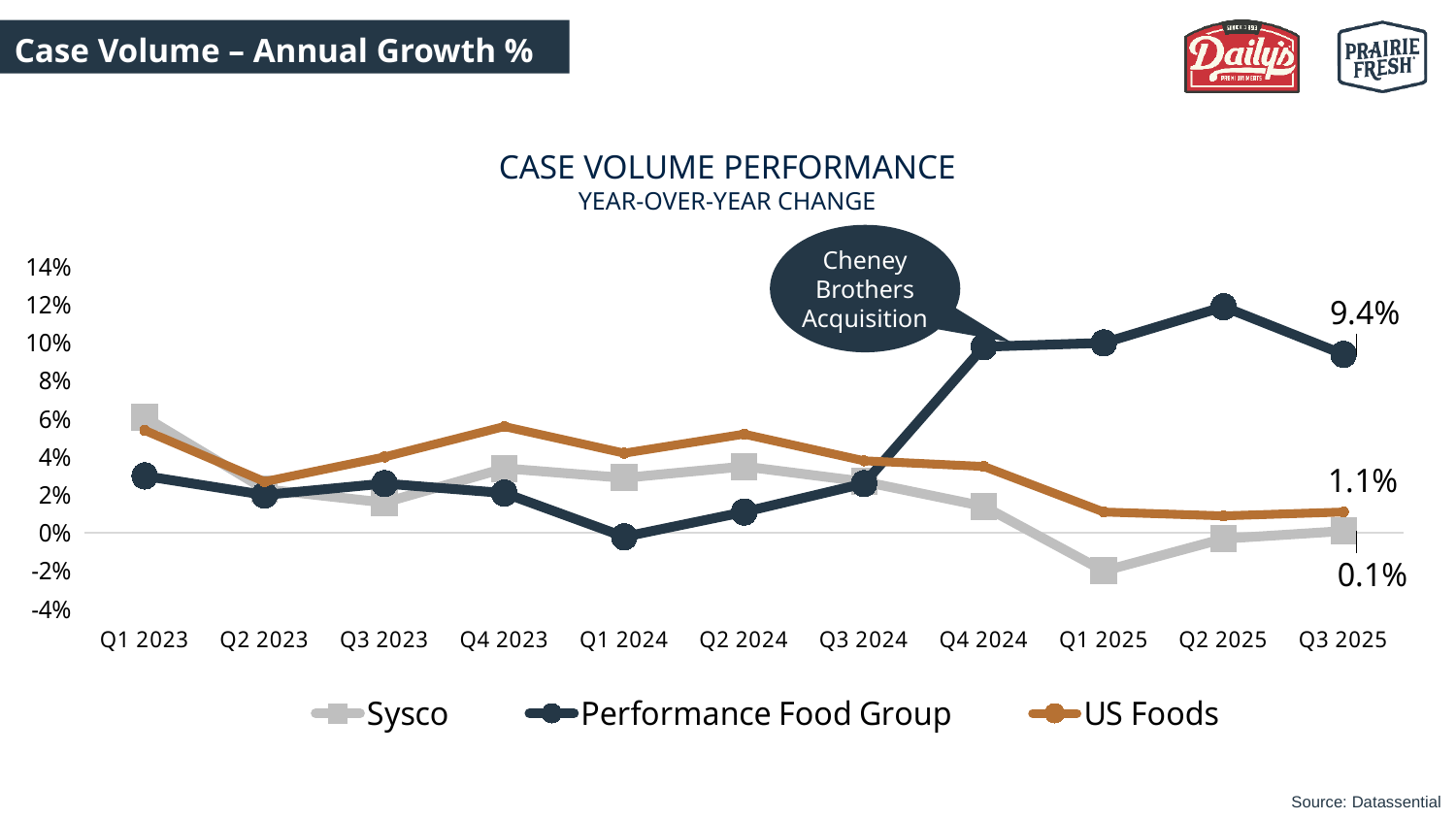
What is the value for Sysco in Q3 2025? 0.1% How many series does the legend list? 3 Which series has the highest value in Q3 2025? Performance Food Group Is the value for Performance Food Group in Q2 2025 greater or less than 10%? greater How many quarters are plotted along the x axis? 11 What is the value for US Foods in Q3 2025? 1.1% Is the value for Sysco in Q1 2025 greater or less than 0%? less What event does the callout on the chart label? Cheney Brothers Acquisition In which quarter does Performance Food Group reach its highest value? Q2 2025 What is the difference between Performance Food Group and US Foods in Q3 2025? 8.3 percentage points What is the value for Performance Food Group in Q3 2025? 9.4% What kind of chart is shown on the slide? Line chart